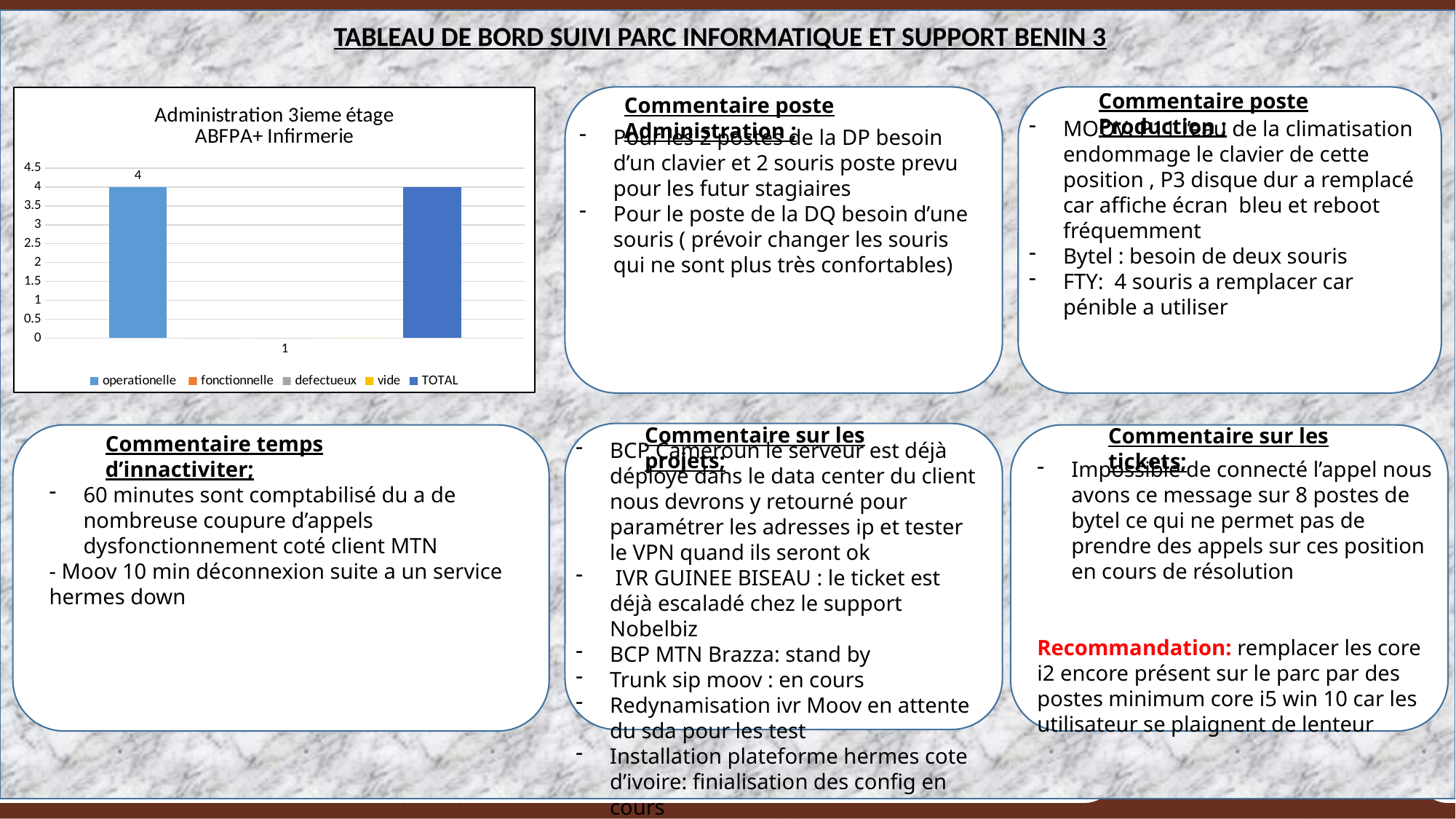
How many categories are shown on the x axis of the chart? 1 What is the highest value shown on the chart's vertical axis? 4.5 What is the value of the operationelle bar? 4 Which series is listed last in the chart legend? TOTAL What is the value of the TOTAL bar? 4 What is the difference between the operationelle value and the TOTAL value? 0 Is the value for fonctionnelle greater or less than 1? less What is the title of the chart? Administration 3ieme étage ABFPA+ Infirmerie Is the value for operationelle greater or less than 3? greater Which is larger, the value for operationelle or the value for fonctionnelle? operationelle What kind of chart is shown on the slide? bar chart How many series does the chart legend list? 5